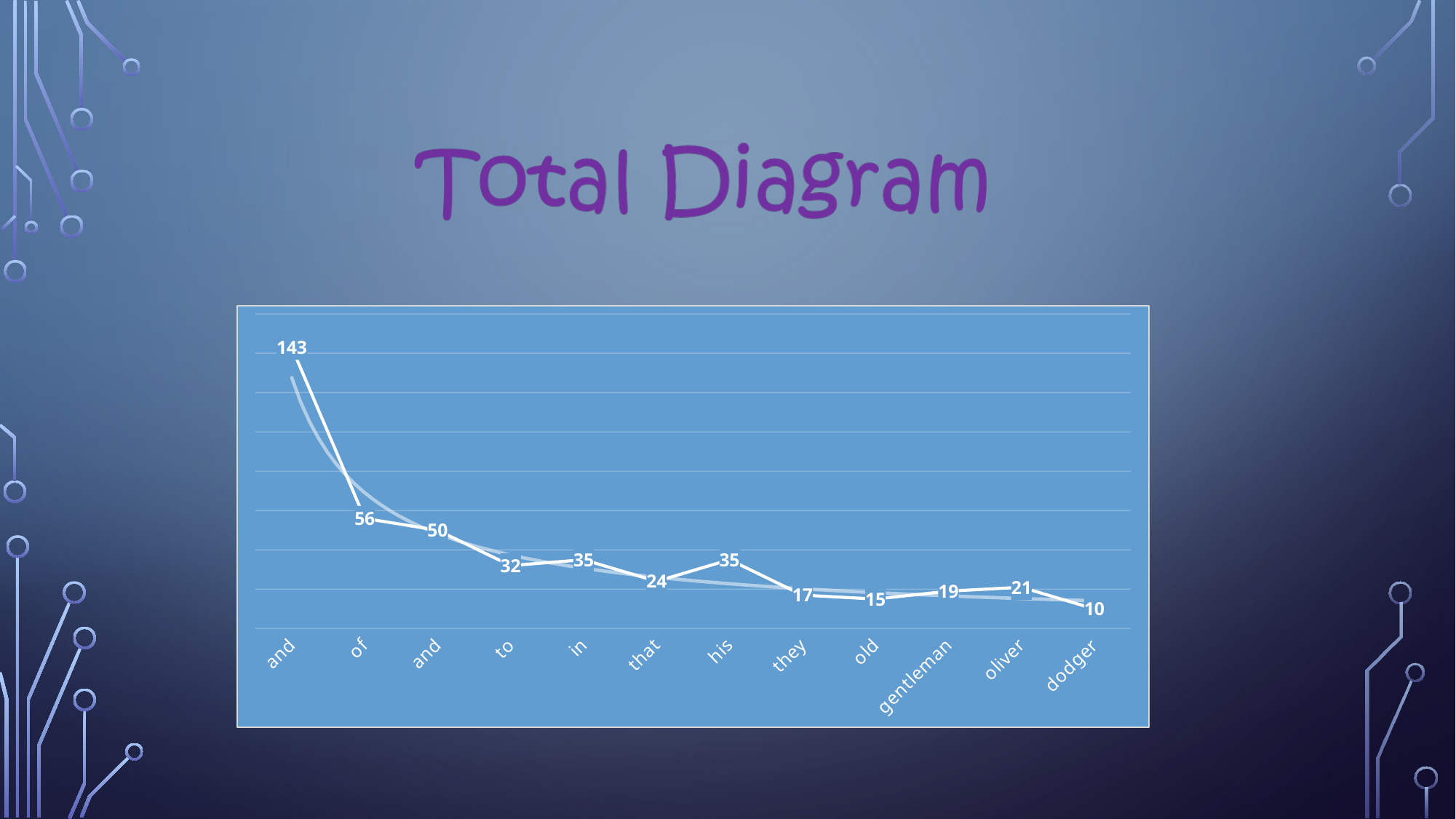
How many categories are plotted on the x axis? 12 Which category has the highest value? and (the first category) Which category has the lowest value? dodger What is the value for "of"? 56 What is the title of the slide containing the chart? Total Diagram What is the value for "gentleman"? 19 What is the value for "that"? 24 Which has a larger value, "oliver" or "old"? oliver What type of chart is shown on the slide? line chart Do the values generally rise or fall from left to right along the x axis? fall What is the value for "dodger"? 10 What is the difference between the values for "of" and "to"? 24